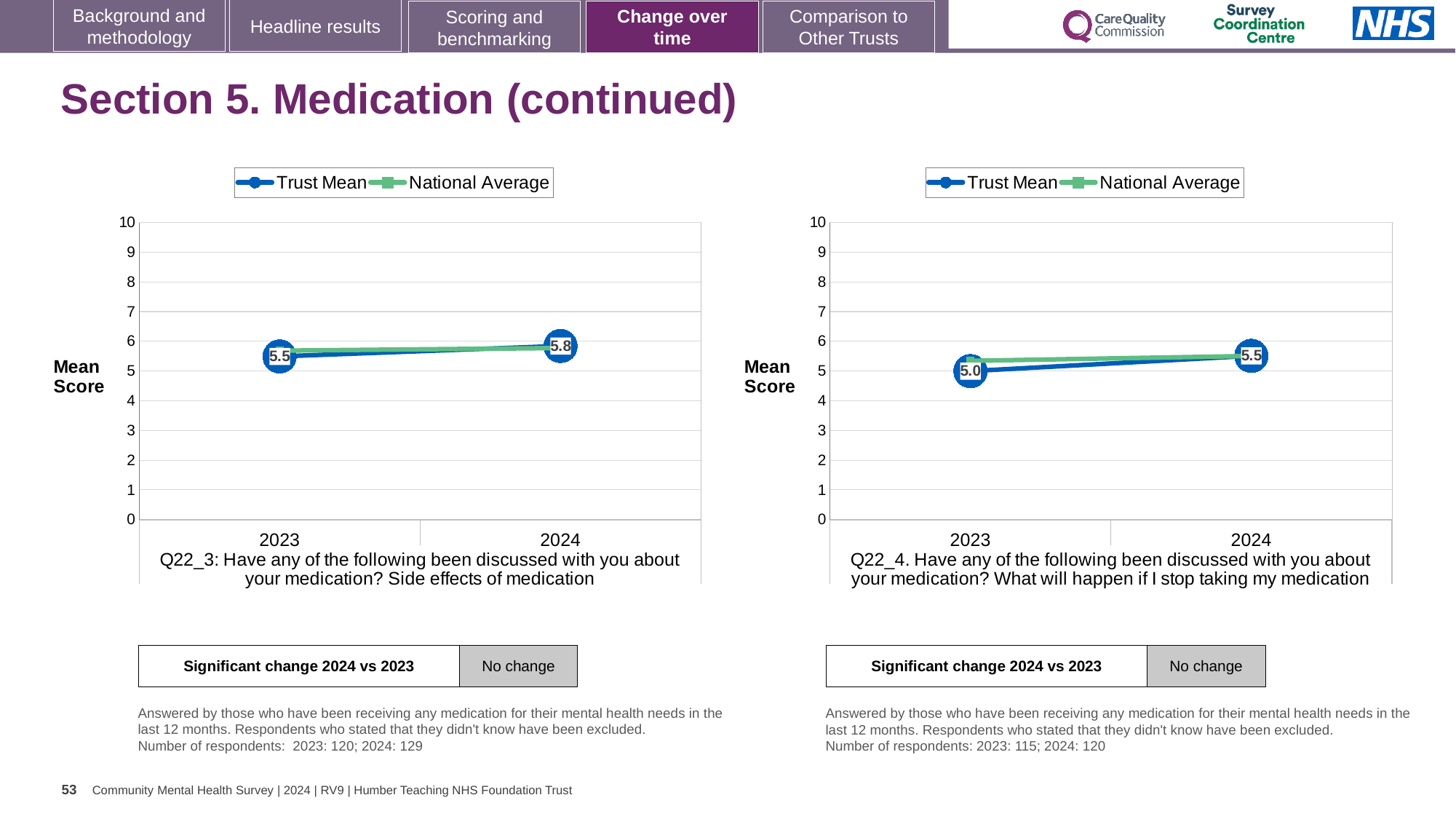
What type of chart is the left chart (Q22_3)? line chart In the right chart (Q22_4), by how much did the Trust Mean change from 2023 to 2024? 0.5 In the left chart (Q22_3), what is the Trust Mean for 2024? 5.8 In the left chart (Q22_3), what is the Trust Mean for 2023? 5.5 In the left chart (Q22_3), is the Trust Mean for 2024 greater or less than 5? greater How many series does the legend of the right chart (Q22_4) list? 2 In the left chart (Q22_3), by how much did the Trust Mean change from 2023 to 2024? 0.3 Which is larger: the 2024 Trust Mean in the left chart (Q22_3) or the 2024 Trust Mean in the right chart (Q22_4)? Left chart (Q22_3), 5.8 In the right chart (Q22_4), what is the Trust Mean for 2024? 5.5 In the right chart (Q22_4), what is the Trust Mean for 2023? 5.0 In the right chart (Q22_4), does the Trust Mean rise or fall from 2023 to 2024? rise How many years are shown on the x axis of the left chart (Q22_3)? 2